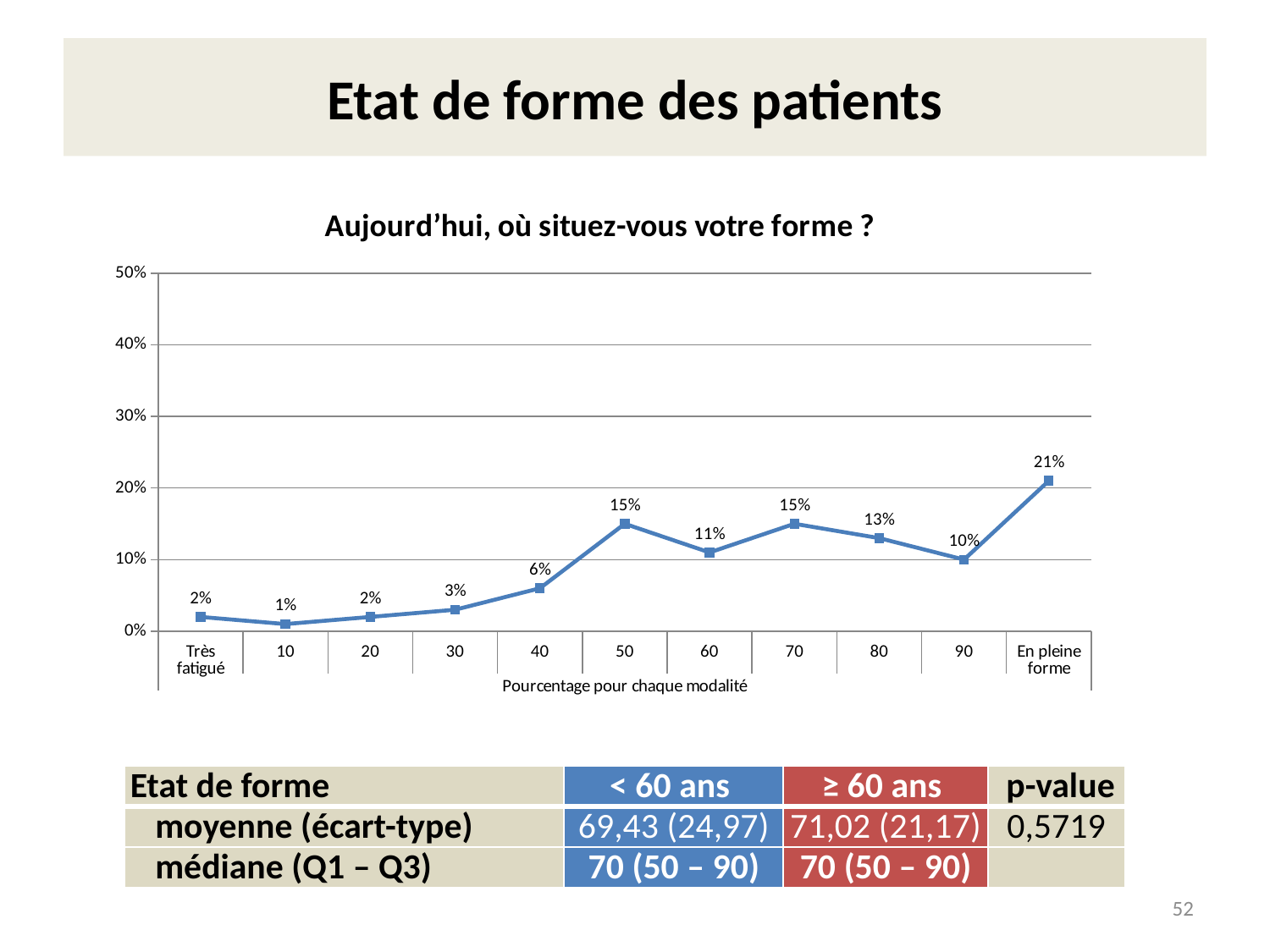
What kind of chart is this? line chart What is the value for 'Très fatigué'? 2% Is the value for 40 greater or less than 10%? less What is the value for the category 50? 15% Which category has the highest value? En pleine forme Which category has the lowest value? 10 How many categories are shown on the x axis? 11 What is the difference between the values for 'En pleine forme' and 90? 11% What is the value for 'En pleine forme'? 21% Which is larger, the value for 60 or the value for 80? 80 Do the values generally rise or fall from 'Très fatigué' to 'En pleine forme'? rise What is the title of the chart? Aujourd’hui, où situez-vous votre forme ?